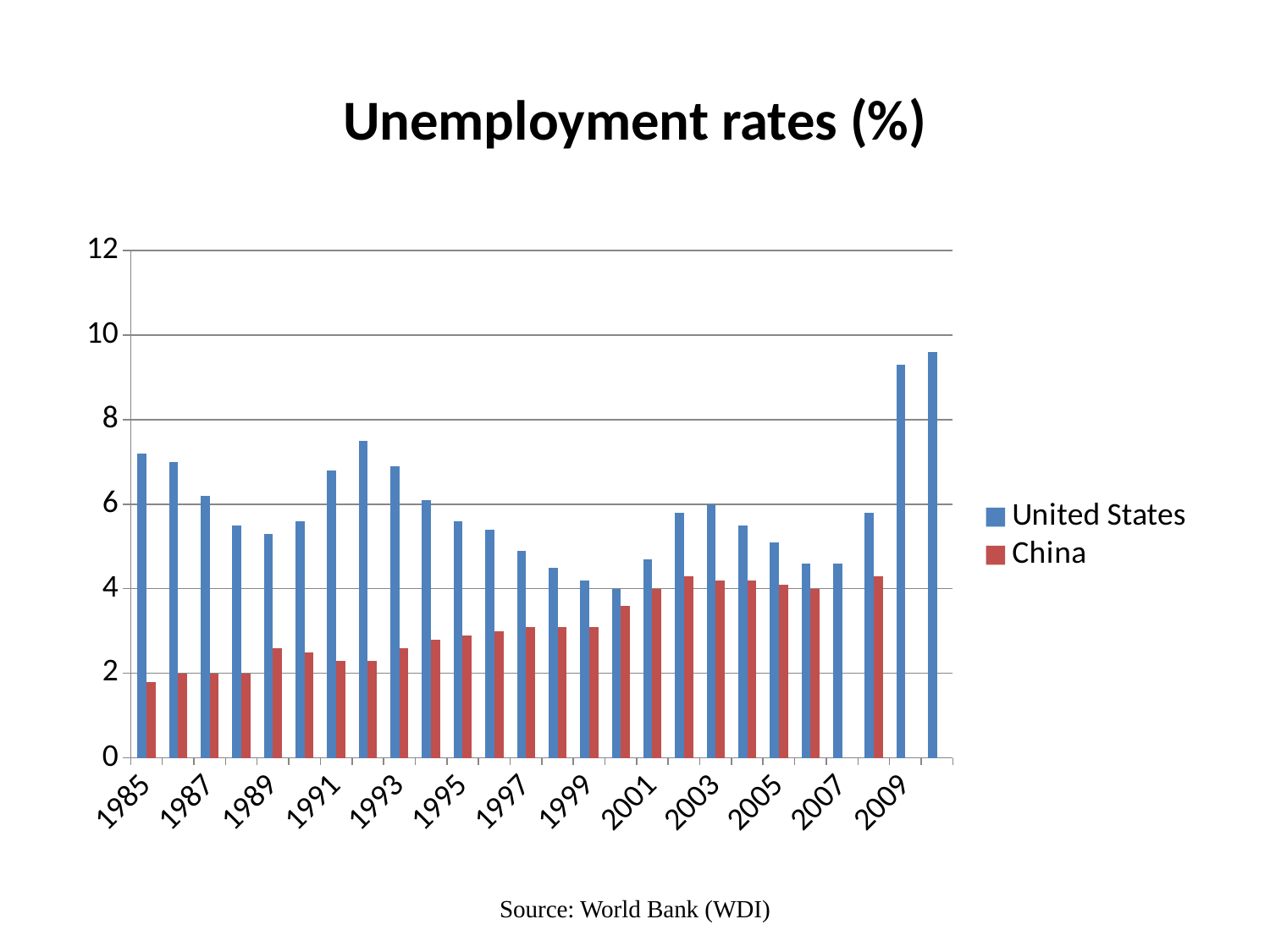
In 1985, which country has the higher unemployment rate, the United States or China? United States What is the title of the chart? Unemployment rates (%) Is the United States unemployment rate in 1999 greater or less than 6? less Is the United States unemployment rate in 2009 greater or less than 8? greater Is the United States unemployment rate in 1985 greater or less than 6? greater Which is larger, the United States unemployment rate in 1985 or in 2009? 2009 Which colour represents China in the chart? red What kind of chart is shown on the slide? bar chart Does the China unemployment rate generally rise or fall from 1985 to 2005? rise How many series does the legend list? 2